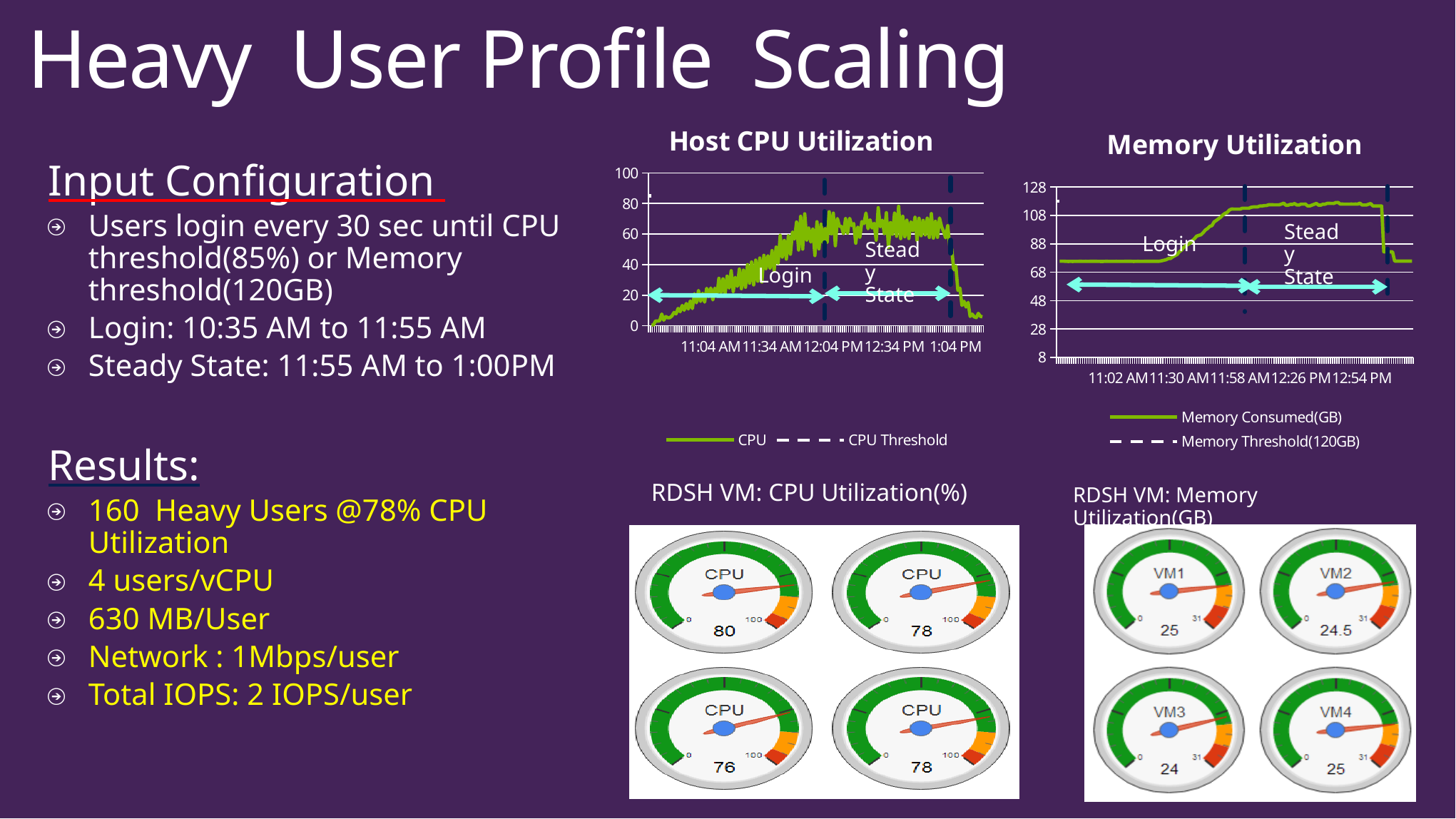
In the RDSH VM: Memory Utilization(GB) gauges, which VM has the lowest value? VM3 In the Host CPU Utilization chart, what are the two legend entries? CPU and CPU Threshold In the Memory Utilization chart, is the Memory Consumed value at 12:26 PM greater or less than 108? greater In the RDSH VM: CPU Utilization(%) gauges, what is the highest value shown? 80 In the Host CPU Utilization chart, does the CPU value rise or fall during the Login period? rise In the Memory Utilization chart, what are the two legend entries? Memory Consumed(GB) and Memory Threshold(120GB) How many series does the legend of the Host CPU Utilization chart list? 2 What kind of chart is the Host CPU Utilization chart? line chart In the Memory Utilization chart, is the Memory Consumed value at 11:02 AM greater or less than 88? less In the RDSH VM: Memory Utilization(GB) gauges, what is the value shown for VM3? 24 In the Host CPU Utilization chart, is the CPU value at 12:34 PM greater or less than 40? greater